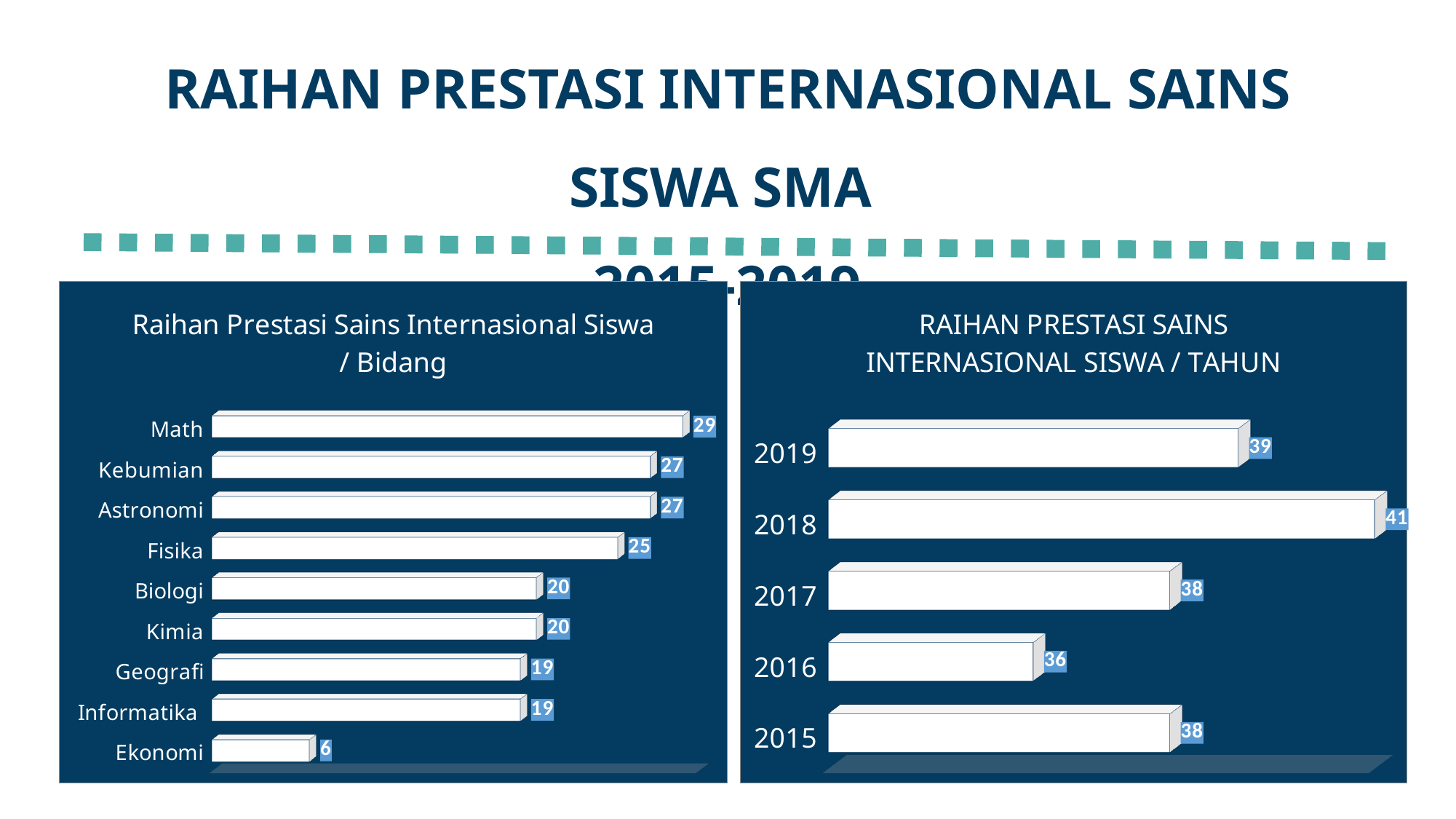
In the left chart (Raihan Prestasi Sains Internasional Siswa / Bidang), what is the value for Math? 29 In the left chart (Raihan Prestasi Sains Internasional Siswa / Bidang), which category has the lowest value? Ekonomi In the right chart (Raihan Prestasi Sains Internasional Siswa / Tahun), which year has the lowest value? 2016 In the left chart (Raihan Prestasi Sains Internasional Siswa / Bidang), how many categories are shown? 9 In the left chart (Raihan Prestasi Sains Internasional Siswa / Bidang), which category has the highest value? Math In the left chart (Raihan Prestasi Sains Internasional Siswa / Bidang), what is the difference between Math and Ekonomi? 23 In the left chart (Raihan Prestasi Sains Internasional Siswa / Bidang), what is the value for Fisika? 25 In the left chart (Raihan Prestasi Sains Internasional Siswa / Bidang), which is larger, Biologi or Geografi? Biologi What type of chart is the right chart (Raihan Prestasi Sains Internasional Siswa / Tahun)? Bar chart In the right chart (Raihan Prestasi Sains Internasional Siswa / Tahun), what is the difference between 2018 and 2016? 5 In the right chart (Raihan Prestasi Sains Internasional Siswa / Tahun), how many years are shown? 5 In the right chart (Raihan Prestasi Sains Internasional Siswa / Tahun), what is the value for 2018? 41